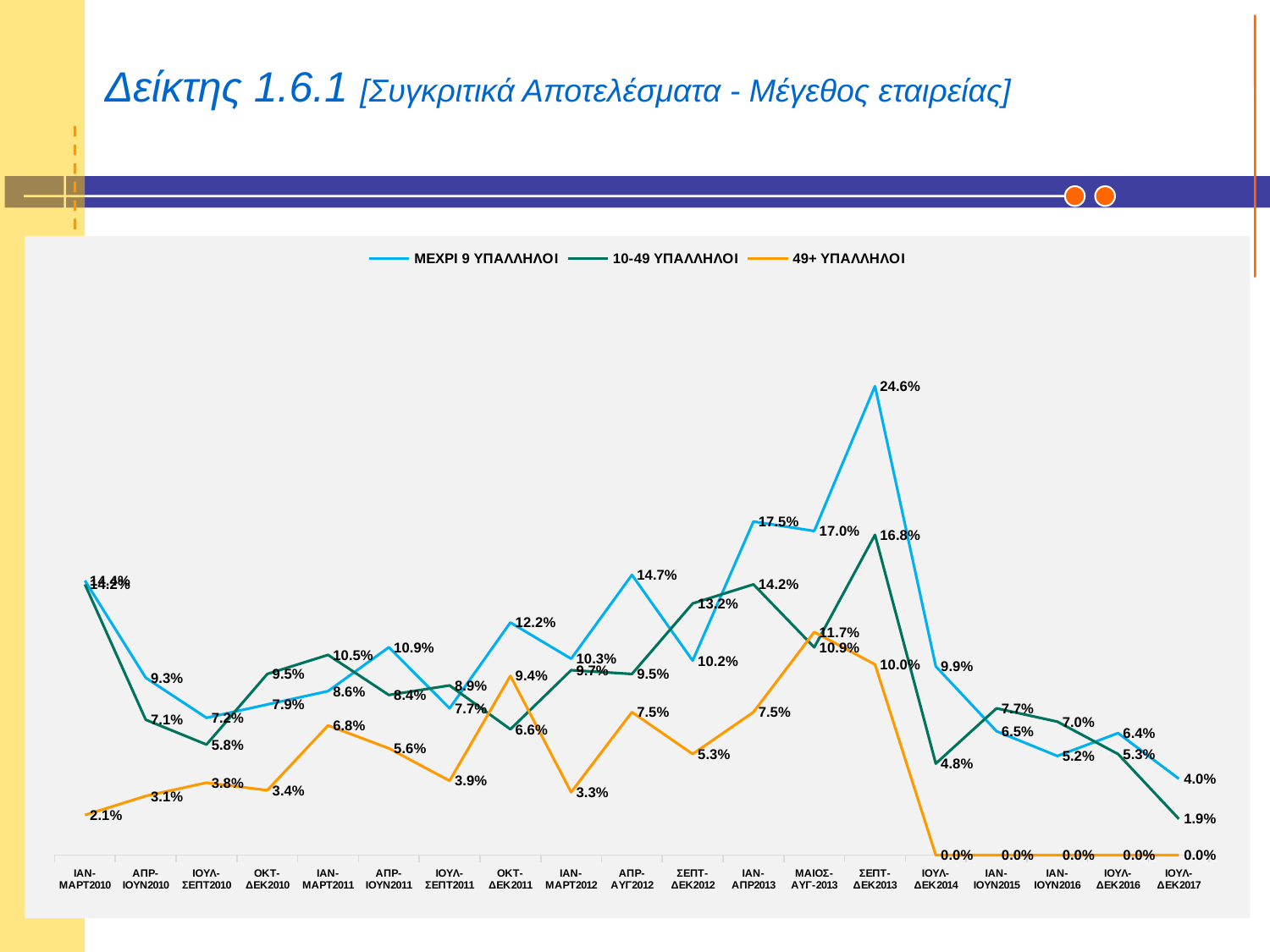
What is the value for 10-49 ΥΠΑΛΛΗΛΟΙ in ΙΟΥΛ-ΔΕΚ2017? 1.9% In which period does ΜΕΧΡΙ 9 ΥΠΑΛΛΗΛΟΙ reach its highest value? ΣΕΠΤ-ΔΕΚ2013 In ΙΑΝ-ΑΠΡ2013, which series has the larger value, ΜΕΧΡΙ 9 ΥΠΑΛΛΗΛΟΙ or 10-49 ΥΠΑΛΛΗΛΟΙ? ΜΕΧΡΙ 9 ΥΠΑΛΛΗΛΟΙ What is the value for 49+ ΥΠΑΛΛΗΛΟΙ in ΟΚΤ-ΔΕΚ2011? 9.4% What is the difference between ΜΕΧΡΙ 9 ΥΠΑΛΛΗΛΟΙ and 10-49 ΥΠΑΛΛΗΛΟΙ in ΣΕΠΤ-ΔΕΚ2013? 7.8 percentage points In which period does 49+ ΥΠΑΛΛΗΛΟΙ reach its highest value? ΜΑΙΟΣ-ΑΥΓ-2013 How many time periods are shown on the x axis? 19 How many series does the legend list? 3 What colour is the line for 49+ ΥΠΑΛΛΗΛΟΙ? orange How many periods show a value of 0.0% for 49+ ΥΠΑΛΛΗΛΟΙ? 5 What is the value for ΜΕΧΡΙ 9 ΥΠΑΛΛΗΛΟΙ in ΣΕΠΤ-ΔΕΚ2013? 24.6% What kind of chart is shown on the slide? line chart